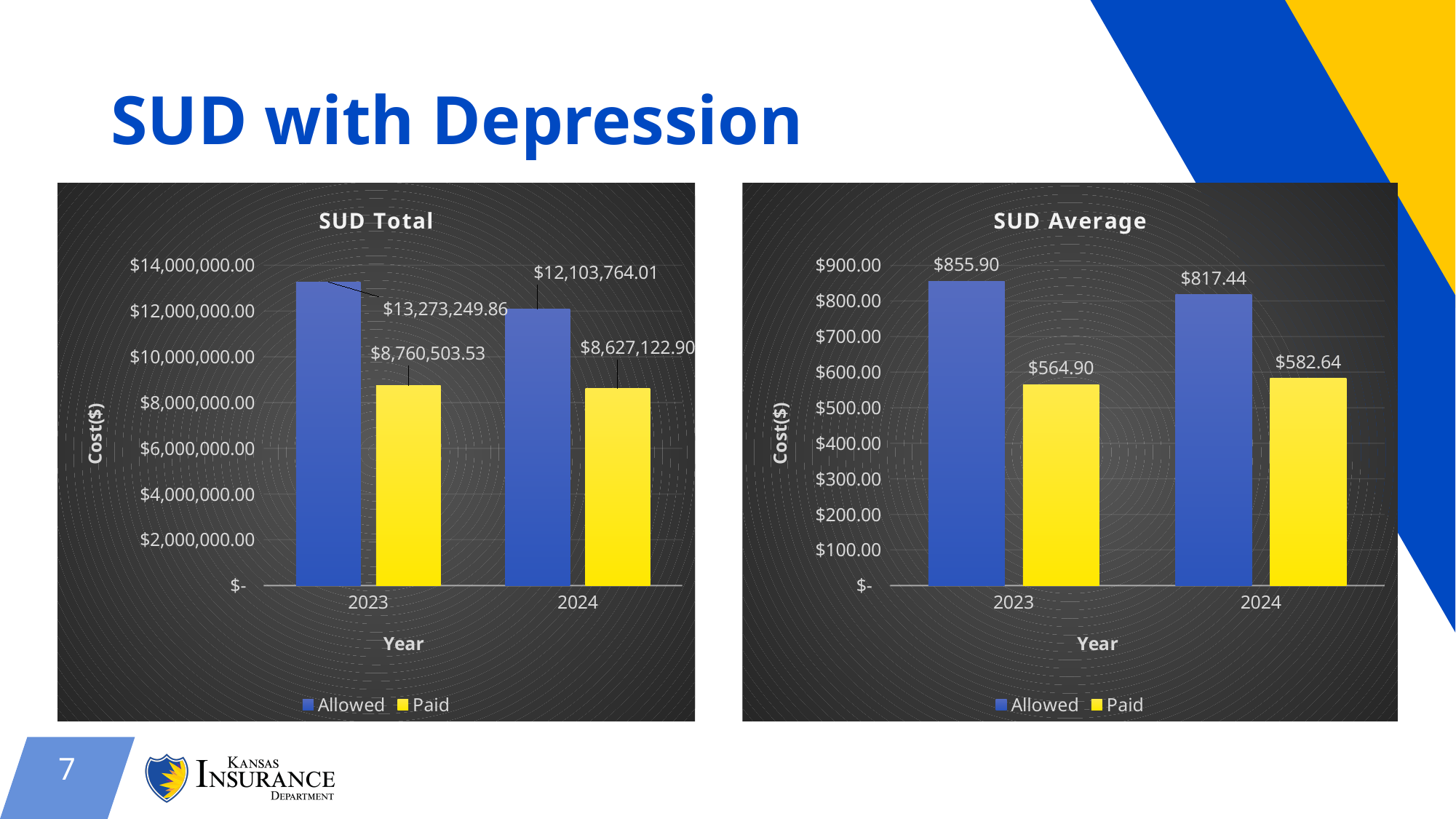
In the SUD Total chart, what is the difference between the Allowed and Paid values for 2023? $4,512,746.33 In the SUD Total chart, what is the Allowed value for 2023? $13,273,249.86 What kind of chart is the SUD Total chart? bar chart In the SUD Average chart, is the Paid value for 2024 larger or smaller than the Paid value for 2023? larger In the SUD Average chart, which year has the lower Paid value? 2023 In the SUD Average chart, what is the Allowed value for 2024? $817.44 How many series does the legend of the SUD Average chart list? 2 In the SUD Total chart, which year has the higher Allowed value? 2023 In the SUD Total chart, does the Allowed value rise or fall from 2023 to 2024? fall In the SUD Total chart, what is the Paid value for 2024? $8,627,122.90 In the SUD Average chart, what is the difference between the Allowed and Paid values for 2024? $234.80 In the SUD Average chart, what is the Paid value for 2023? $564.90